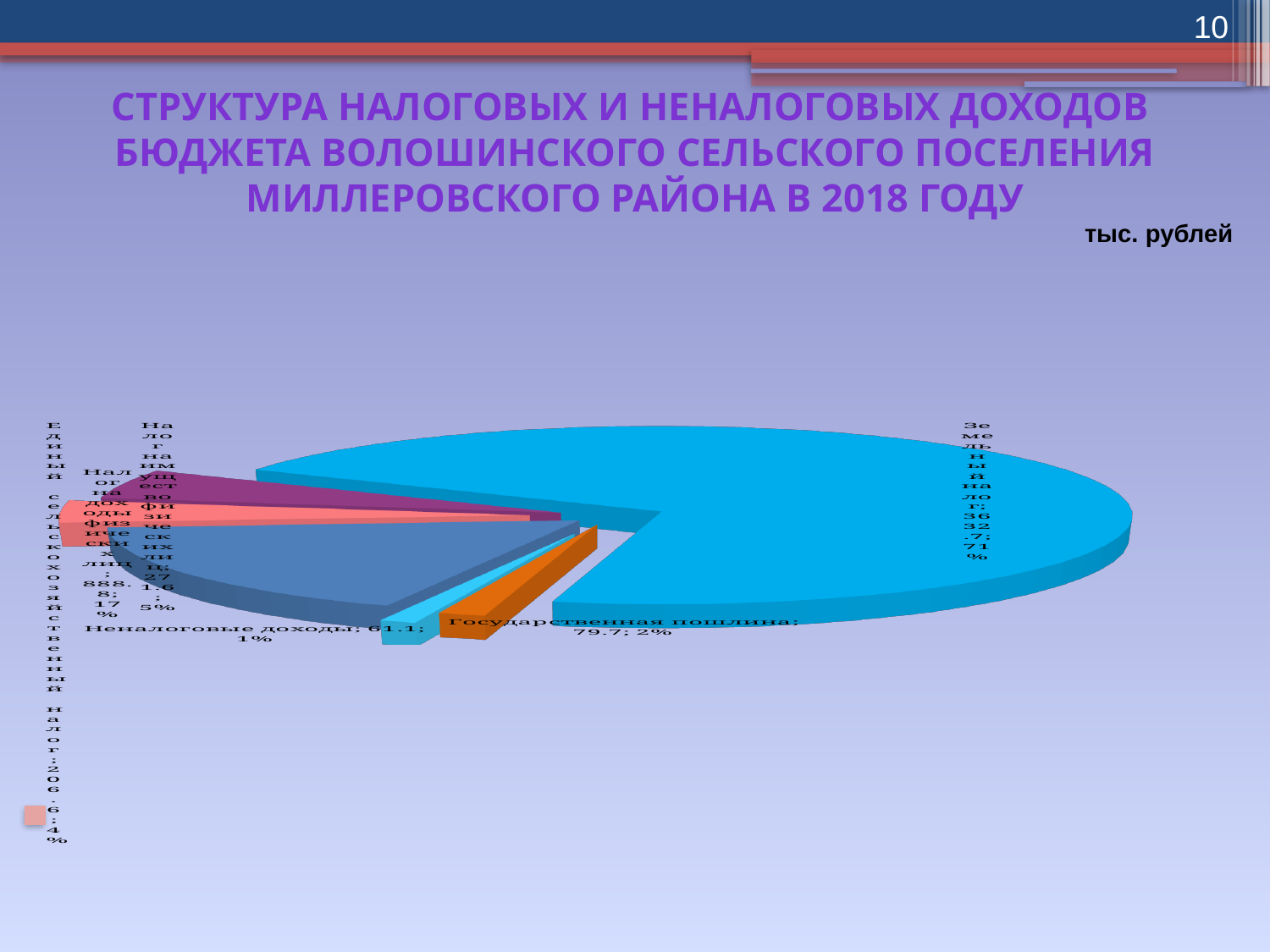
What is the value for Земельный налог? 3632.7 In what units are the values on the chart given? тыс. рублей What is the difference between the values for Земельный налог and Налог на доходы физических лиц? 2743.9 Which category has the largest slice of the pie? Земельный налог What kind of chart is shown on the slide? pie chart Which is larger, the value for Государственная пошлина or the value for Неналоговые доходы? Государственная пошлина What share of the pie does Налог на доходы физических лиц represent? 17% What is the value for Государственная пошлина? 79.7 What share of the pie does Земельный налог represent? 71% What is the value for Неналоговые доходы? 61.1 How many slices does the pie chart have? 6 Which category has the smallest slice of the pie? Неналоговые доходы